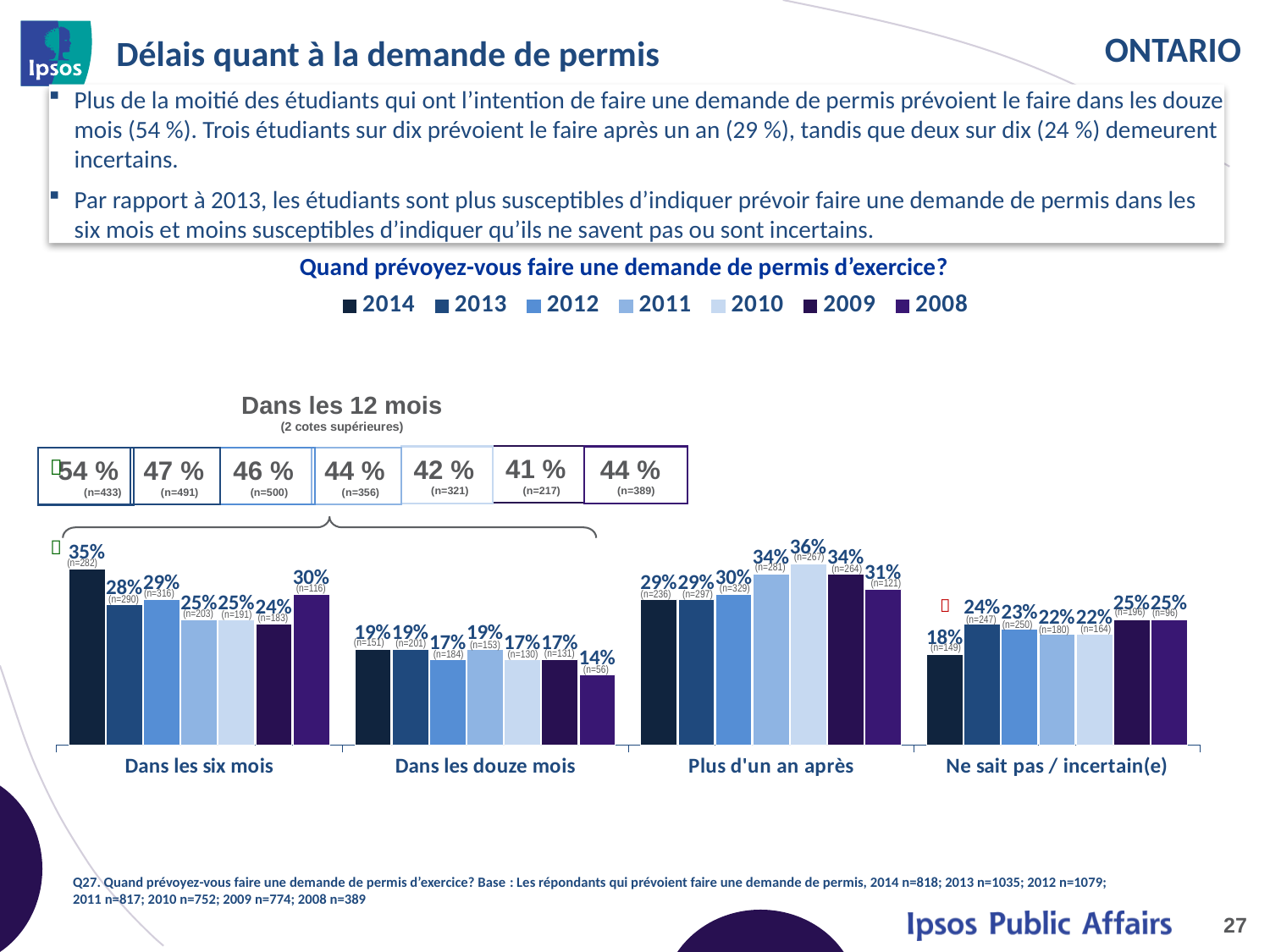
How many categories are shown on the x axis of the chart? 4 What is the title of the chart? Quand prévoyez-vous faire une demande de permis d'exercice? Which year has the lowest value in the 'Ne sait pas / incertain(e)' category? 2014 What is the difference between the 2014 and 2013 values in the 'Dans les six mois' category? 7% Which year has the highest value in the 'Dans les six mois' category? 2014 Which is larger: the 2014 value for 'Dans les six mois' or the 2014 value for 'Plus d'un an après'? Dans les six mois What is the value for 2010 in the 'Plus d'un an après' category? 36% How many series does the legend list? 7 What is the value for 2014 in the 'Dans les six mois' category? 35% What is the value for 2014 in the 'Ne sait pas / incertain(e)' category? 18% What kind of chart is shown on the slide? bar chart What is the value for 2008 in the 'Dans les douze mois' category? 14%